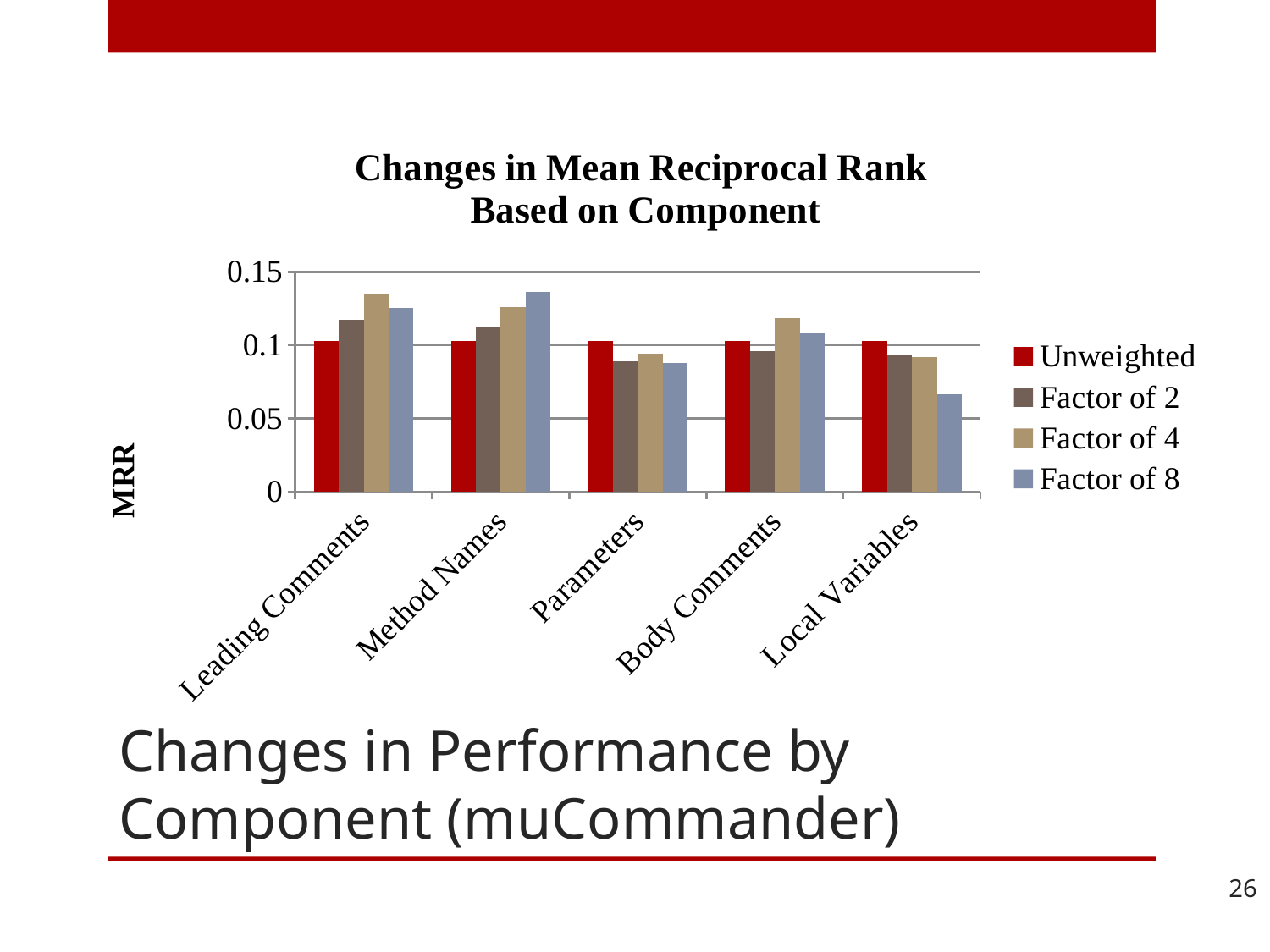
Which component has the lowest Factor of 8 value? Local Variables How many component categories are shown on the x axis of the chart? 5 Is the Factor of 4 value for Leading Comments greater or less than 0.1? greater Is the Factor of 8 value for Local Variables greater or less than 0.1? less Which is larger: the Factor of 2 value for Leading Comments or the Factor of 2 value for Parameters? Leading Comments What is the title of the chart? Changes in Mean Reciprocal Rank Based on Component Is the Factor of 2 value for Parameters greater or less than 0.1? less How many series does the chart's legend list? 4 What kind of chart is shown on the slide? bar chart Which component has the highest Factor of 8 value? Method Names What is the label on the vertical axis of the chart? MRR